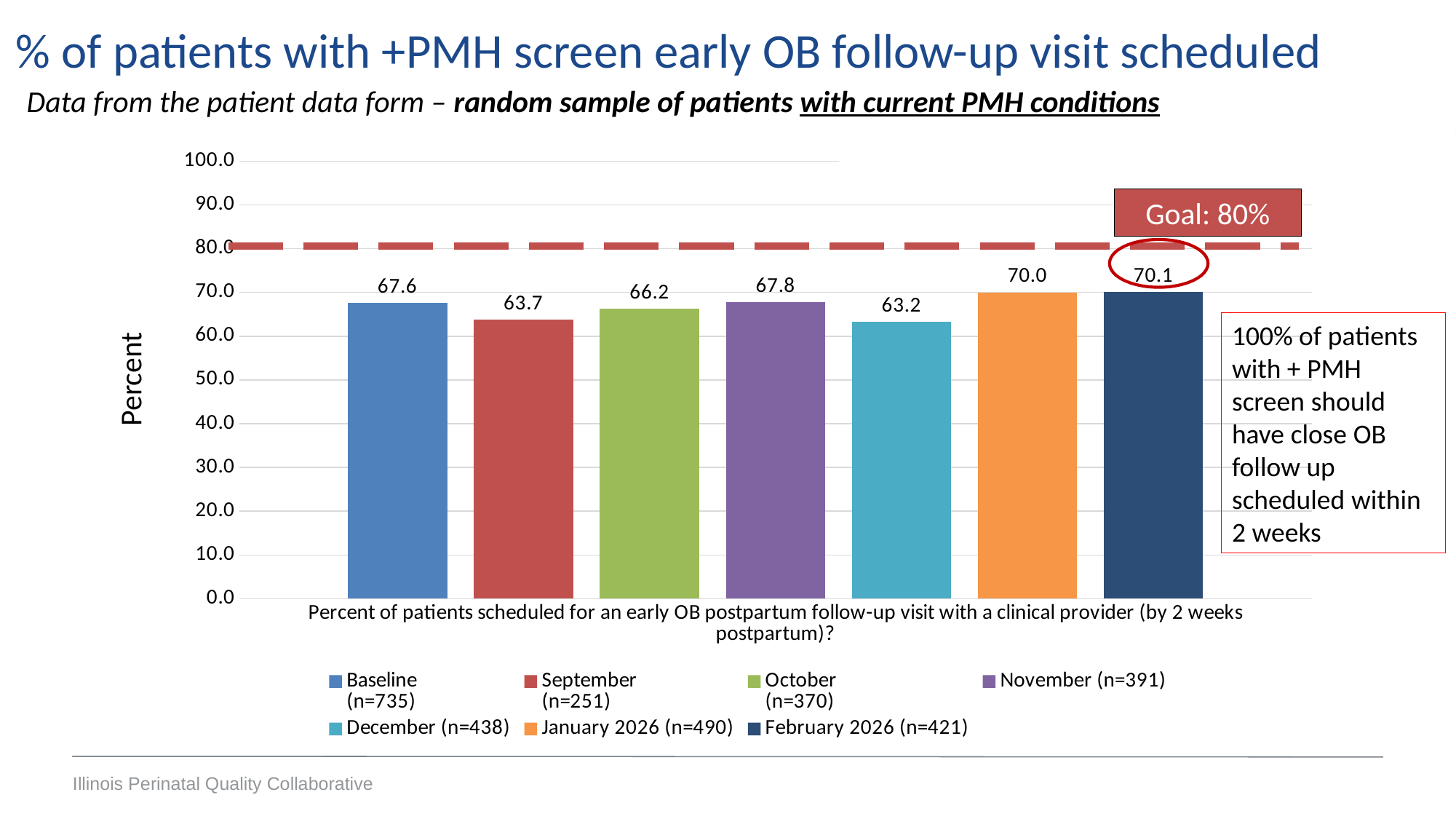
What is the value for December (n=438)? 63.2 Which series has the highest value? February 2026 (n=421) What is the value for February 2026 (n=421)? 70.1 What is the label of the vertical axis? Percent What goal value is shown by the dashed line on the chart? 80% What kind of chart is shown on the slide? bar chart Which is larger, the value for October (n=370) or the value for November (n=391)? November (n=391) What is the value for Baseline (n=735)? 67.6 Which series has the lowest value? December (n=438) Is the value for February 2026 (n=421) greater or less than 80.0? less How many series does the legend list? 7 What is the difference between the values for January 2026 (n=490) and September (n=251)? 6.3